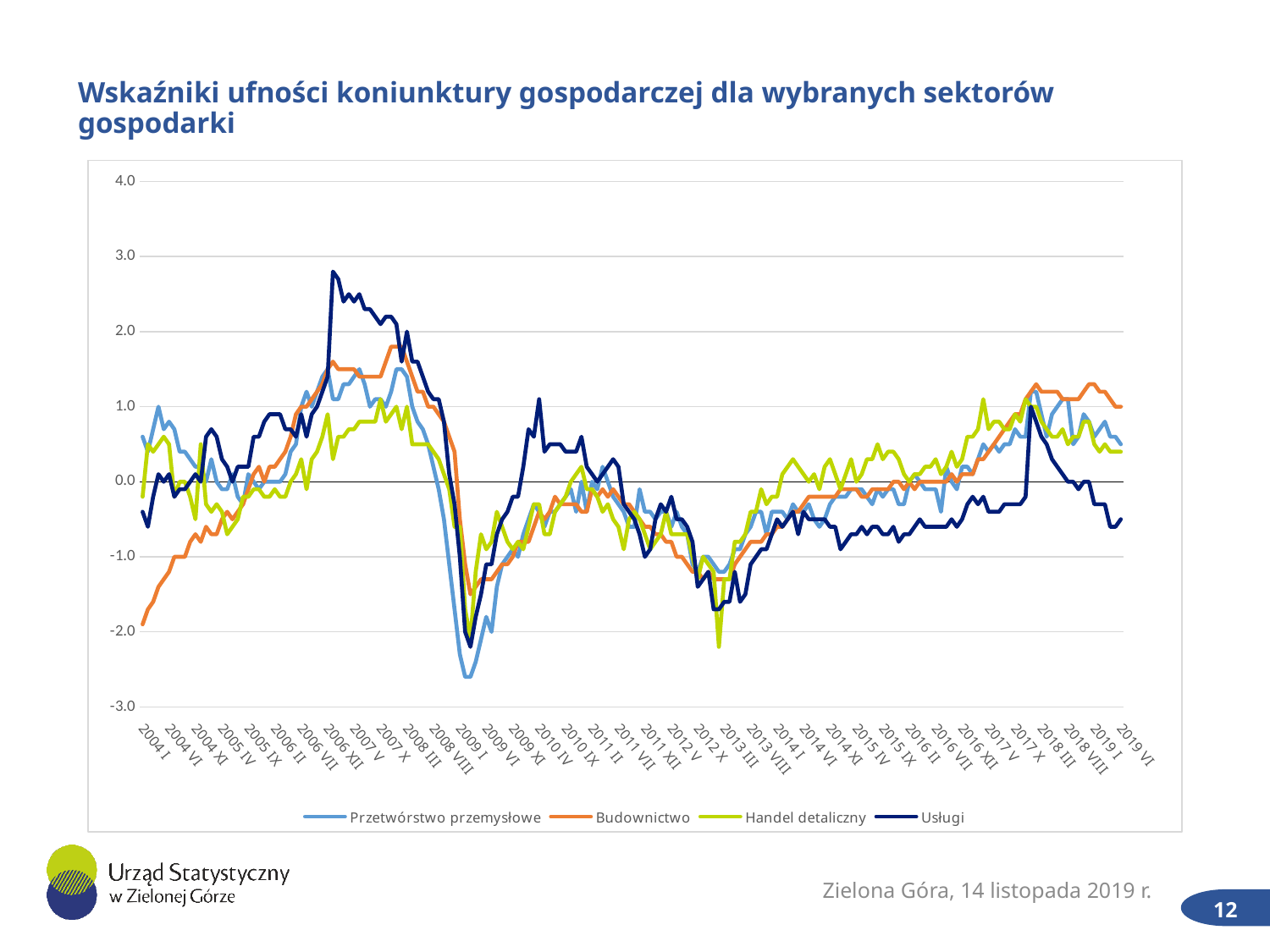
Which series are listed in the legend? Przetwórstwo przemysłowe, Budownictwo, Handel detaliczny, Usługi What kind of chart is shown on the slide? line chart Around 2006 XII, which series has the larger value, Usługi or Handel detaliczny? Usługi At 2019 VI, which series has the larger value, Budownictwo or Usługi? Budownictwo What is the title of the chart? Wskaźniki ufności koniunktury gospodarczej dla wybranych sektorów gospodarki Which series reaches the highest value anywhere on the chart? Usługi Is the lowest value of the Przetwórstwo przemysłowe series around 2009 I greater or less than -2.0? less Is the peak value of the Usługi series around 2006 XII greater or less than 2.0? greater How many series does the legend list? 4 Is the value for Usługi at 2019 VI greater or less than 0.0? less